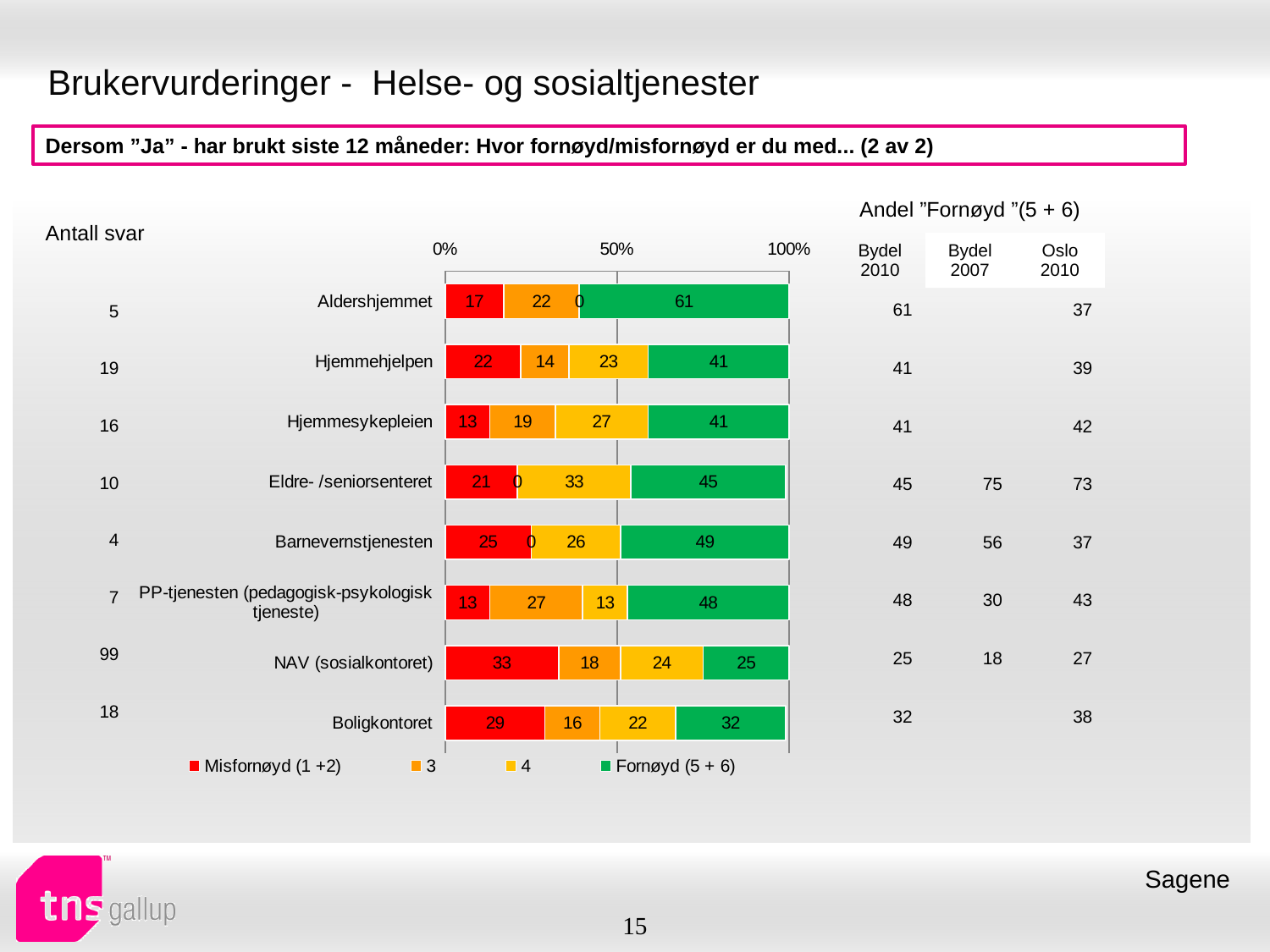
Which category has the lowest "Fornøyd (5 + 6)" value? NAV (sosialkontoret) What is the value of "Misfornøyd (1 +2)" for NAV (sosialkontoret)? 33 What is the difference between the "Fornøyd (5 + 6)" values for Aldershjemmet and Boligkontoret? 29 Which category has the highest "Fornøyd (5 + 6)" value? Aldershjemmet Which is larger: the "Misfornøyd (1 +2)" value for Boligkontoret or for Hjemmehjelpen? Boligkontoret What is the value of series "3" for PP-tjenesten (pedagogisk-psykologisk tjeneste)? 27 How many series does the legend list? 4 What is the value of series "4" for Eldre- /seniorsenteret? 33 What kind of chart is shown on the slide? Stacked bar chart How many categories are shown in the bar chart? 8 What is the total of the stacked bar for Aldershjemmet? 100 What is the value of "Fornøyd (5 + 6)" for Aldershjemmet? 61